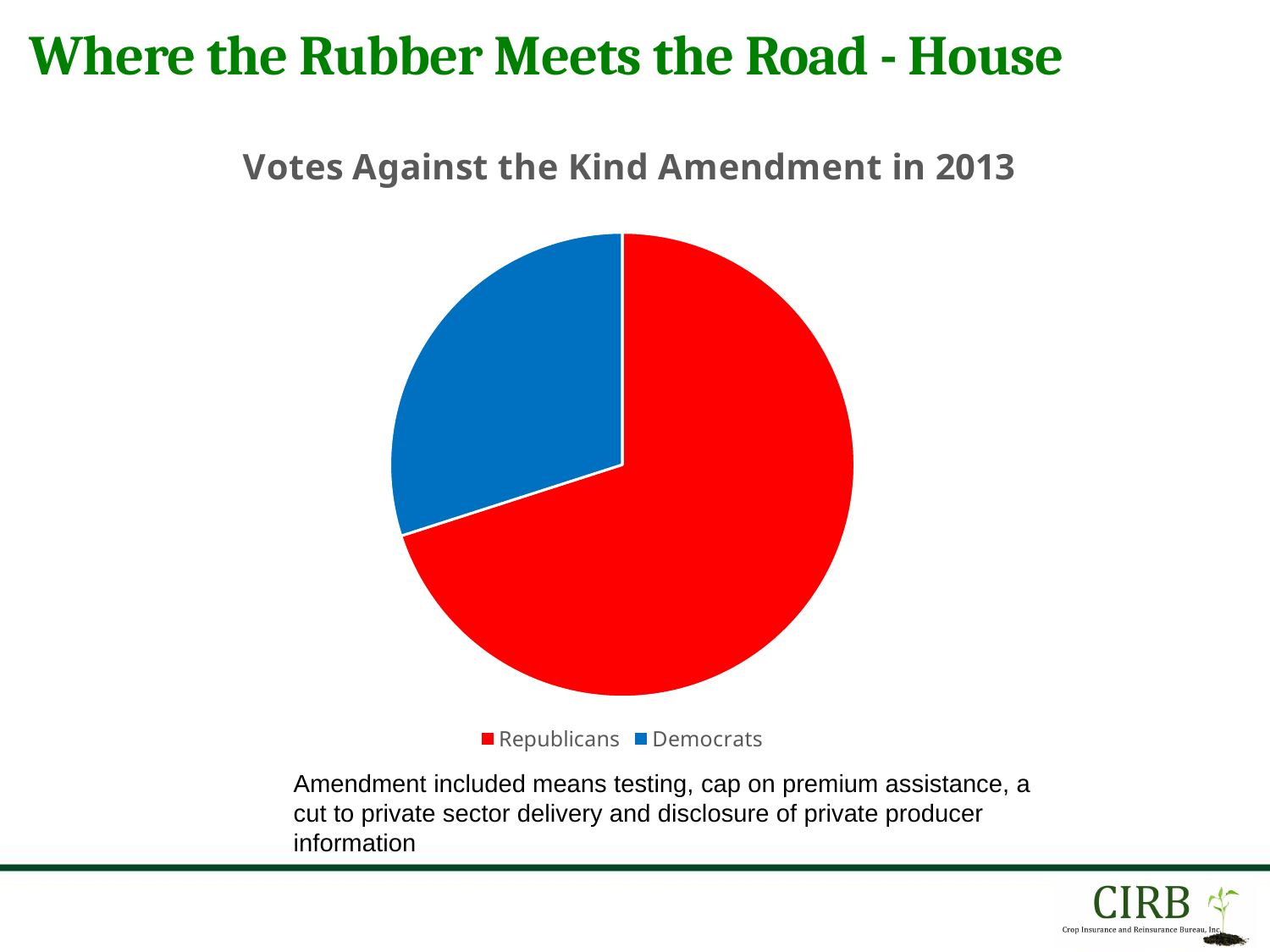
What kind of chart is shown on the slide? pie chart What is the title of the chart? Votes Against the Kind Amendment in 2013 Which slice of the pie is the smallest? Democrats Which slice of the pie is the largest? Republicans What colour is the Republicans slice? red Which is larger, the Republicans slice or the Democrats slice? Republicans How many series does the legend list? 2 How many slices does the pie chart have? 2